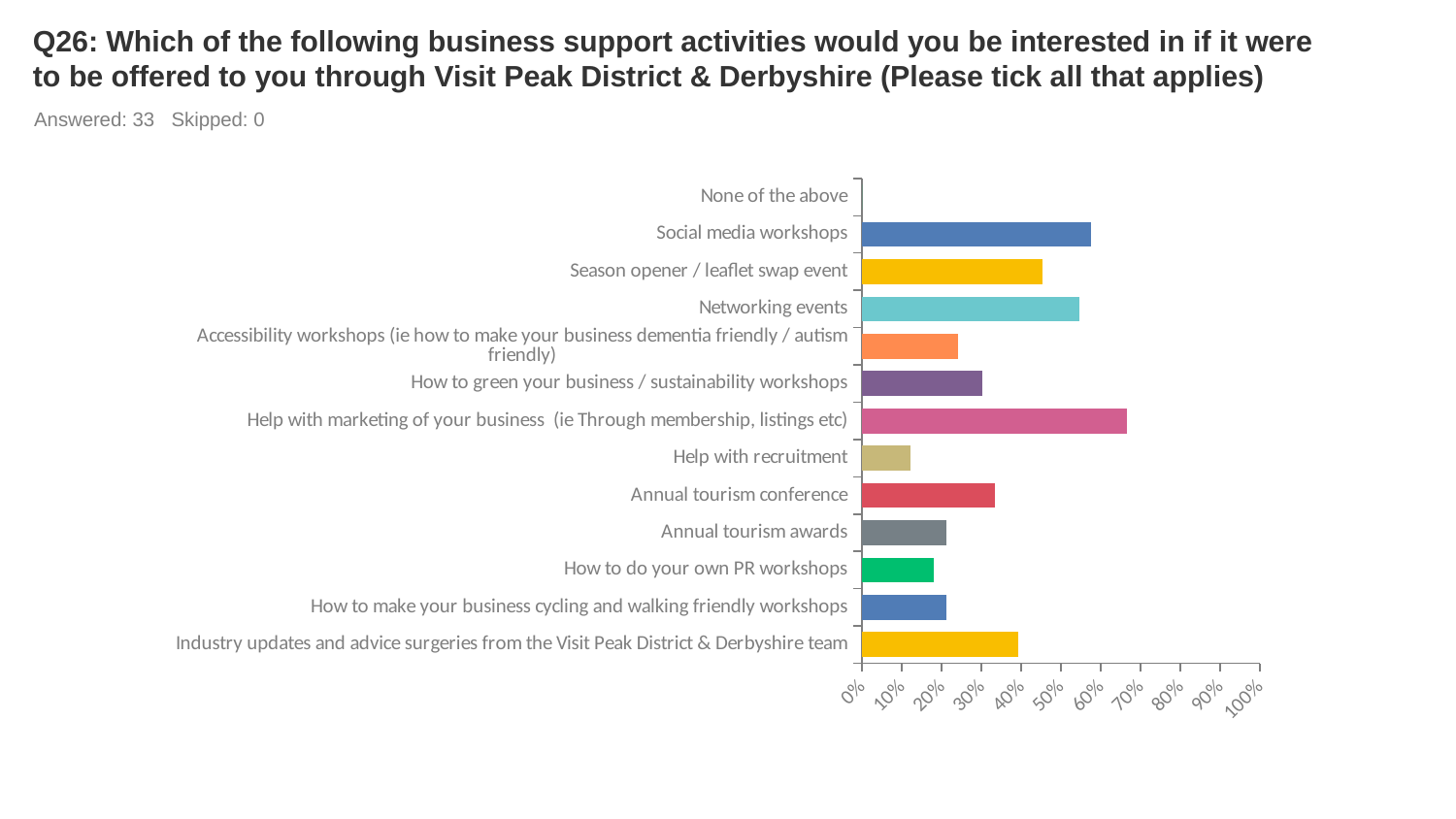
What kind of chart is shown on the slide? Bar chart Is the value for Help with marketing of your business greater or less than 60%? greater Which is larger: Social media workshops or Season opener / leaflet swap event? Social media workshops Which activity has the highest percentage of interest? Help with marketing of your business (ie Through membership, listings etc) Is the value for Accessibility workshops greater or less than 30%? less How many respondents answered this question according to the slide? 33 Is the value for Networking events greater or less than 50%? greater Which category has the lowest value on the chart? None of the above Which is larger: Annual tourism conference or Annual tourism awards? Annual tourism conference How many business support activities (categories) are listed on the chart? 13